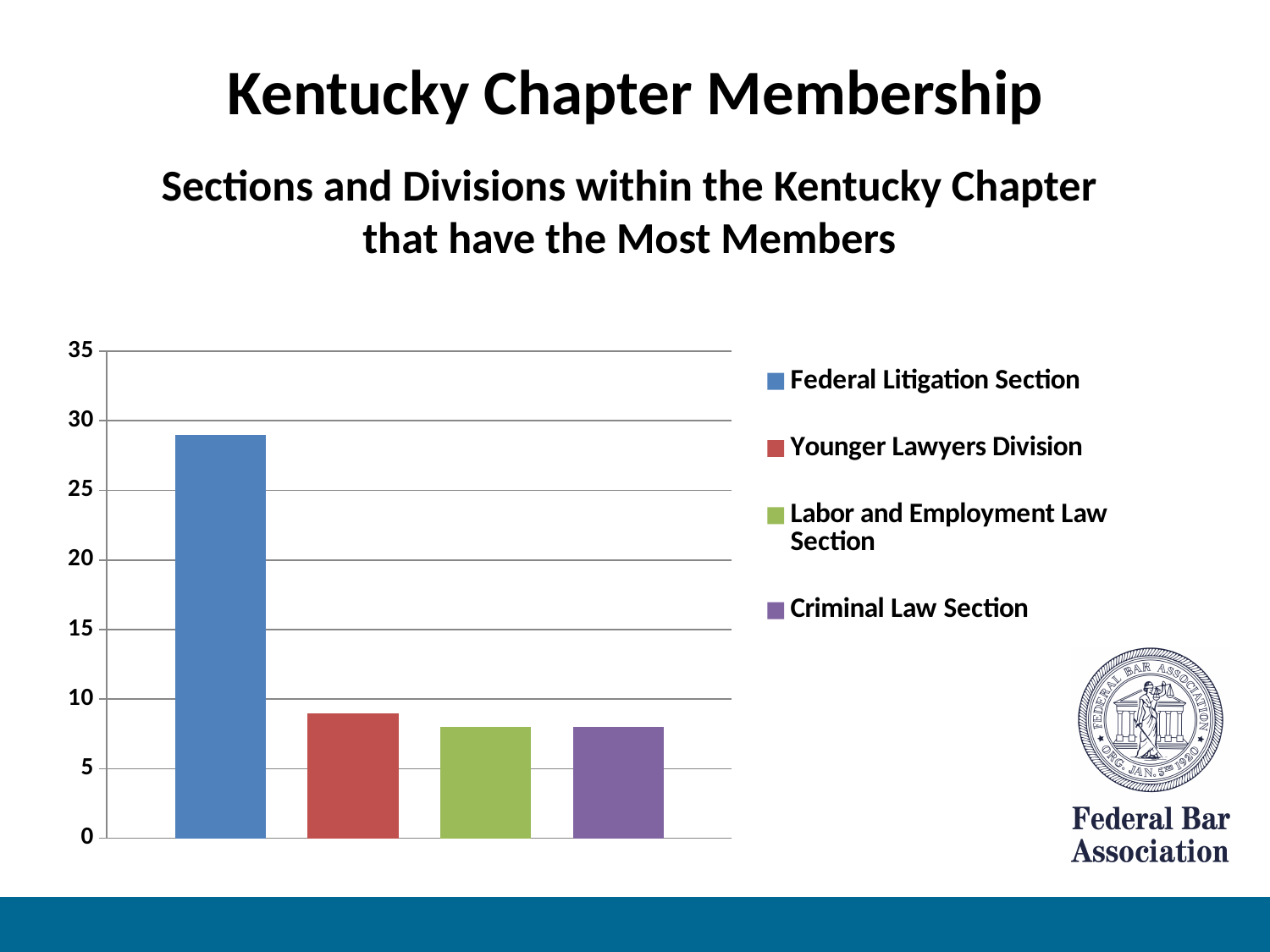
Which is larger, the value for Federal Litigation Section or the value for Younger Lawyers Division? Federal Litigation Section How many entries does the chart legend list? 4 What is the title of the chart on the slide? Sections and Divisions within the Kentucky Chapter that have the Most Members Is the value for Federal Litigation Section greater or less than 30? less Is the value for Younger Lawyers Division greater or less than 10? less Which section or division has the highest number of members in the chart? Federal Litigation Section What colour is the bar for Criminal Law Section? purple Is the value for Labor and Employment Law Section greater or less than 10? less What kind of chart is shown on the slide? bar chart How many bars are plotted in the chart? 4